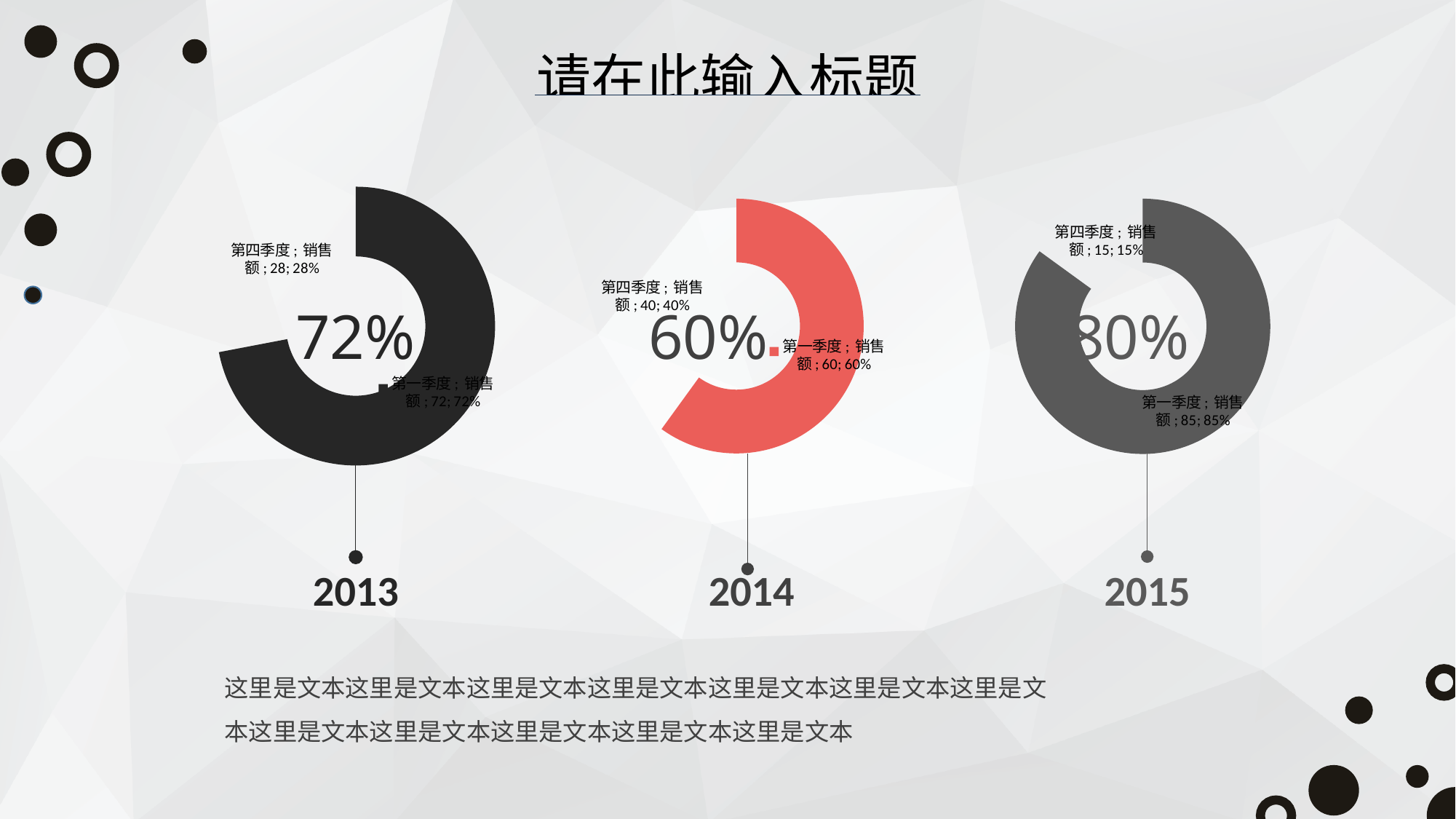
In the 2014 chart, which segment is the smallest? 第四季度 In the 2014 chart, what share of the doughnut does 第一季度 销售额 take? 60% What kind of chart is shown for 2013? doughnut chart What colour is the 2014 doughnut chart? red In the 2015 chart, what is the value for 第一季度 销售额? 85 In the 2013 chart, what is the value for 第一季度 销售额? 72 In the 2013 chart, what is the difference between the 第一季度 and 第四季度 values? 44 In the 2015 chart, what share of the doughnut does 第四季度 销售额 take? 15% In the 2015 chart, which segment is larger, 第一季度 or 第四季度? 第一季度 How many segments does the 2014 doughnut chart have? 2 In the 2013 chart, what share of the doughnut does 第四季度 销售额 take? 28% In the 2014 chart, what is the value for 第四季度 销售额? 40